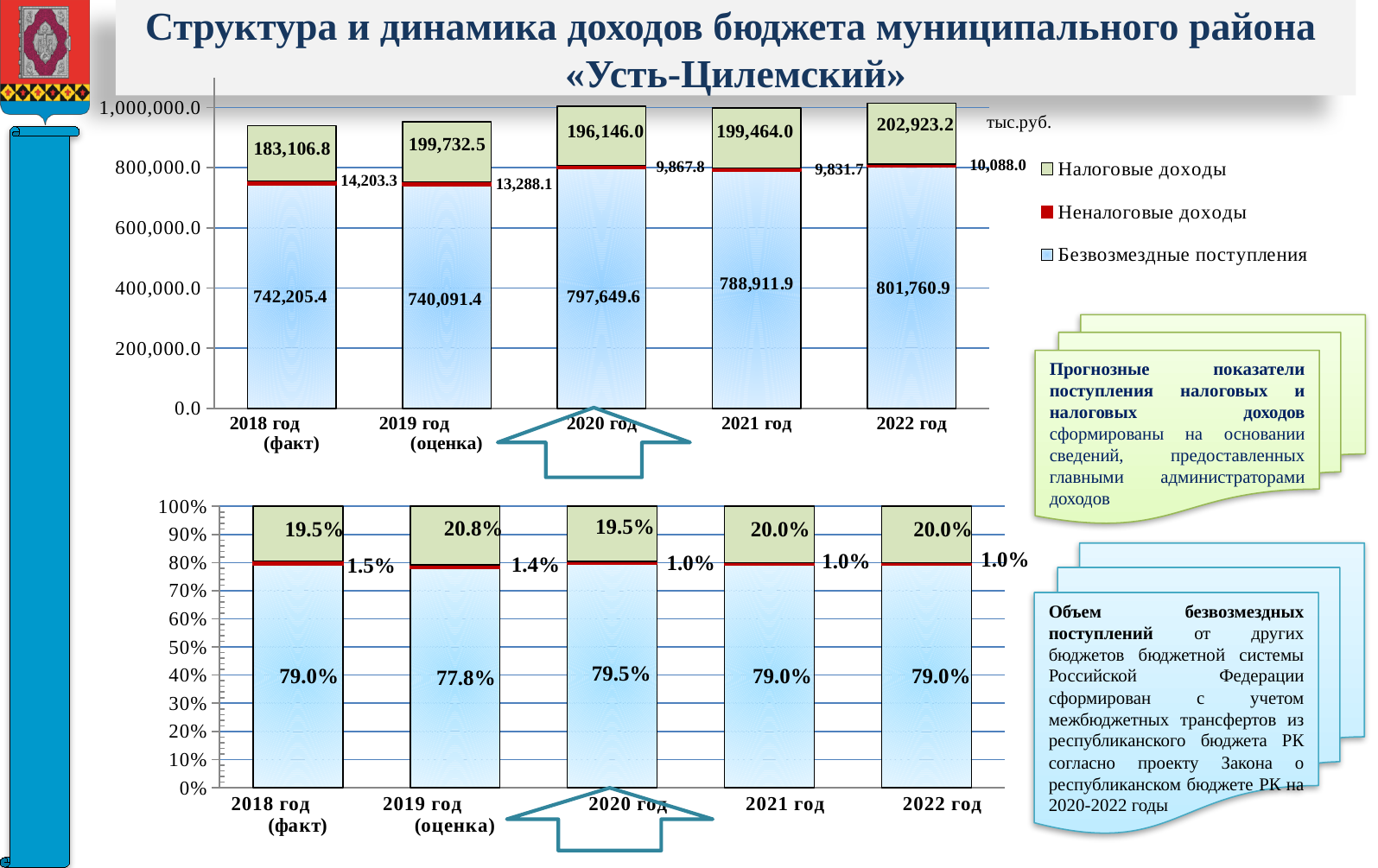
In the top chart, which year has the highest value of Безвозмездные поступления? 2022 год In the bottom chart, which year has the lowest share of Безвозмездные поступления? 2019 год (оценка) In the top chart, which year has the lowest value of Неналоговые доходы? 2021 год How many series does the legend list? 3 In the top chart, what is the total of the stacked bar for 2018 год (факт)? 939,515.5 In the top chart, what is the value of Неналоговые доходы for 2022 год? 10,088.0 In the top chart, what is the difference between Налоговые доходы in 2022 год and in 2018 год (факт)? 19,816.4 What type of chart is the top chart? Stacked bar chart In the top chart, what is the value of Безвозмездные поступления for 2020 год? 797,649.6 In the bottom chart, what is the share of Налоговые доходы for 2019 год (оценка)? 20.8% In the top chart, what is the value of Налоговые доходы for 2018 год (факт)? 183,106.8 In the top chart, is Безвозмездные поступления for 2019 год (оценка) larger or smaller than for 2021 год? smaller